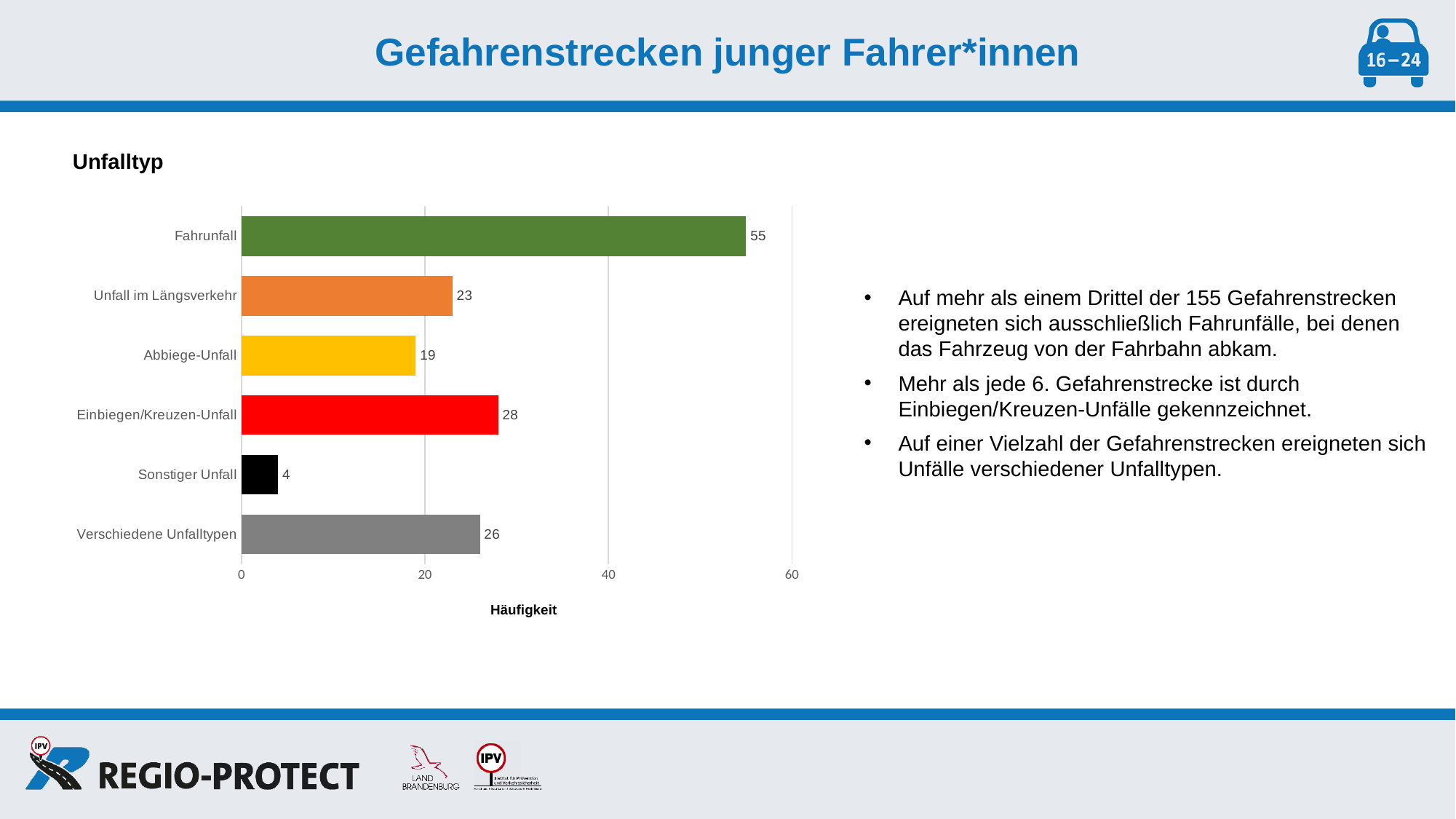
Is the value for Verschiedene Unfalltypen greater or less than 20? greater What is the value for Einbiegen/Kreuzen-Unfall? 28 Which is larger, the value for Unfall im Längsverkehr or the value for Abbiege-Unfall? Unfall im Längsverkehr What is the value for Verschiedene Unfalltypen? 26 What kind of chart is shown on the slide? bar chart Which category has the lowest value? Sonstiger Unfall What is the label of the horizontal axis of the chart? Häufigkeit Which category has the highest value? Fahrunfall What is the value for Fahrunfall? 55 What is the value for Sonstiger Unfall? 4 How many categories are shown in the chart? 6 What is the difference between the values for Fahrunfall and Einbiegen/Kreuzen-Unfall? 27